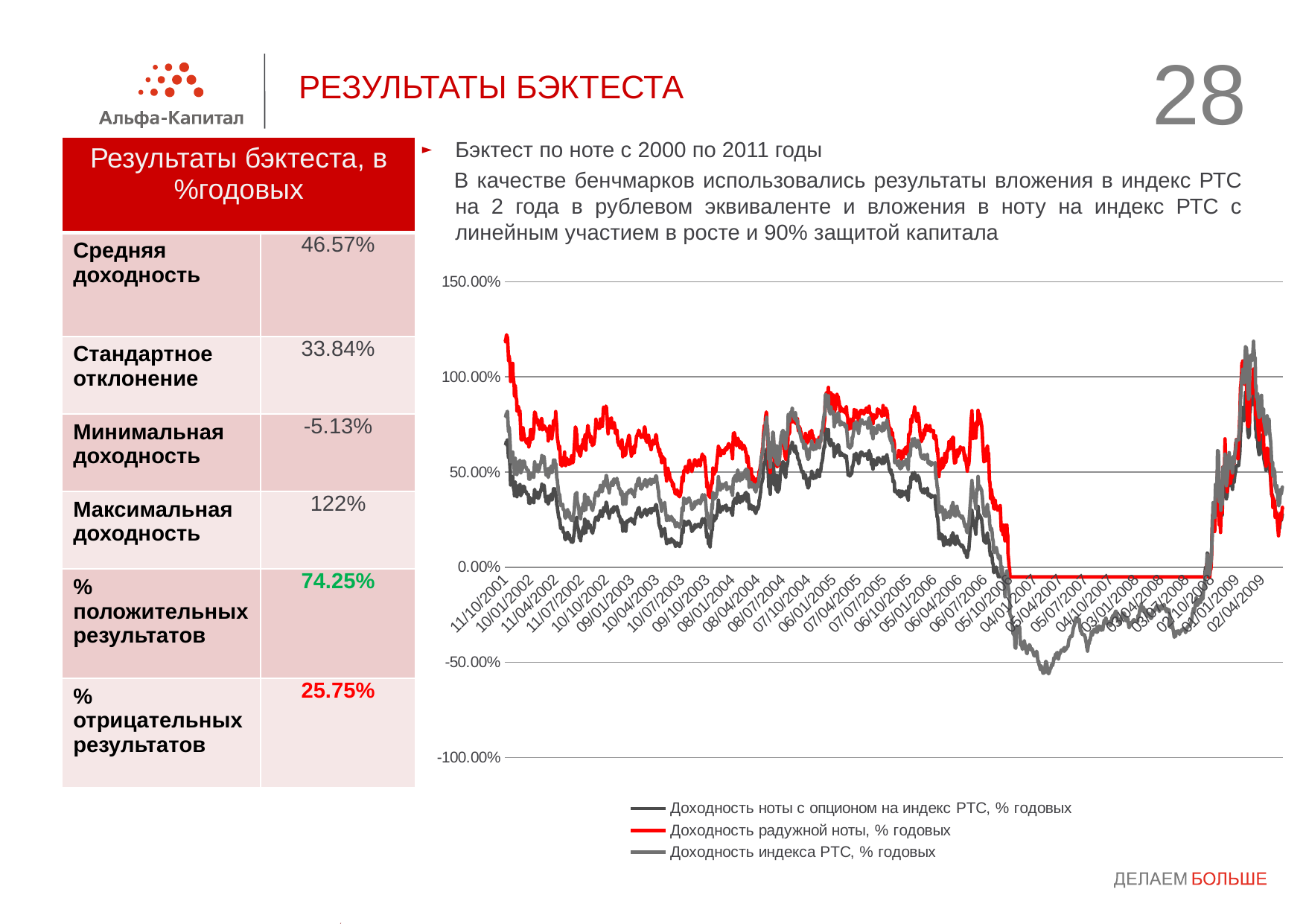
Does 'Доходность радужной ноты, % годовых' rise or fall between 06/07/2006 and 05/10/2006? fall Does 'Доходность индекса РТС, % годовых' rise or fall between 02/10/2008 and 01/01/2009? rise Is the value of 'Доходность радужной ноты, % годовых' at 11/10/2001 greater or less than 100%? greater What is the highest value shown on the chart's vertical axis? 150.00% Which series is drawn in red on the chart? Доходность радужной ноты, % годовых Is the value of 'Доходность ноты с опционом на индекс РТС, % годовых' at 11/10/2001 greater or less than 100%? less Is the value of 'Доходность индекса РТС, % годовых' at 03/01/2008 greater or less than 0%? less What kind of chart is shown on the slide? line chart How many series does the chart legend list? 3 At 11/10/2001, which series has the higher value: 'Доходность радужной ноты, % годовых' or 'Доходность индекса РТС, % годовых'? Доходность радужной ноты, % годовых At 03/01/2008, which series has the higher value: 'Доходность радужной ноты, % годовых' or 'Доходность индекса РТС, % годовых'? Доходность радужной ноты, % годовых